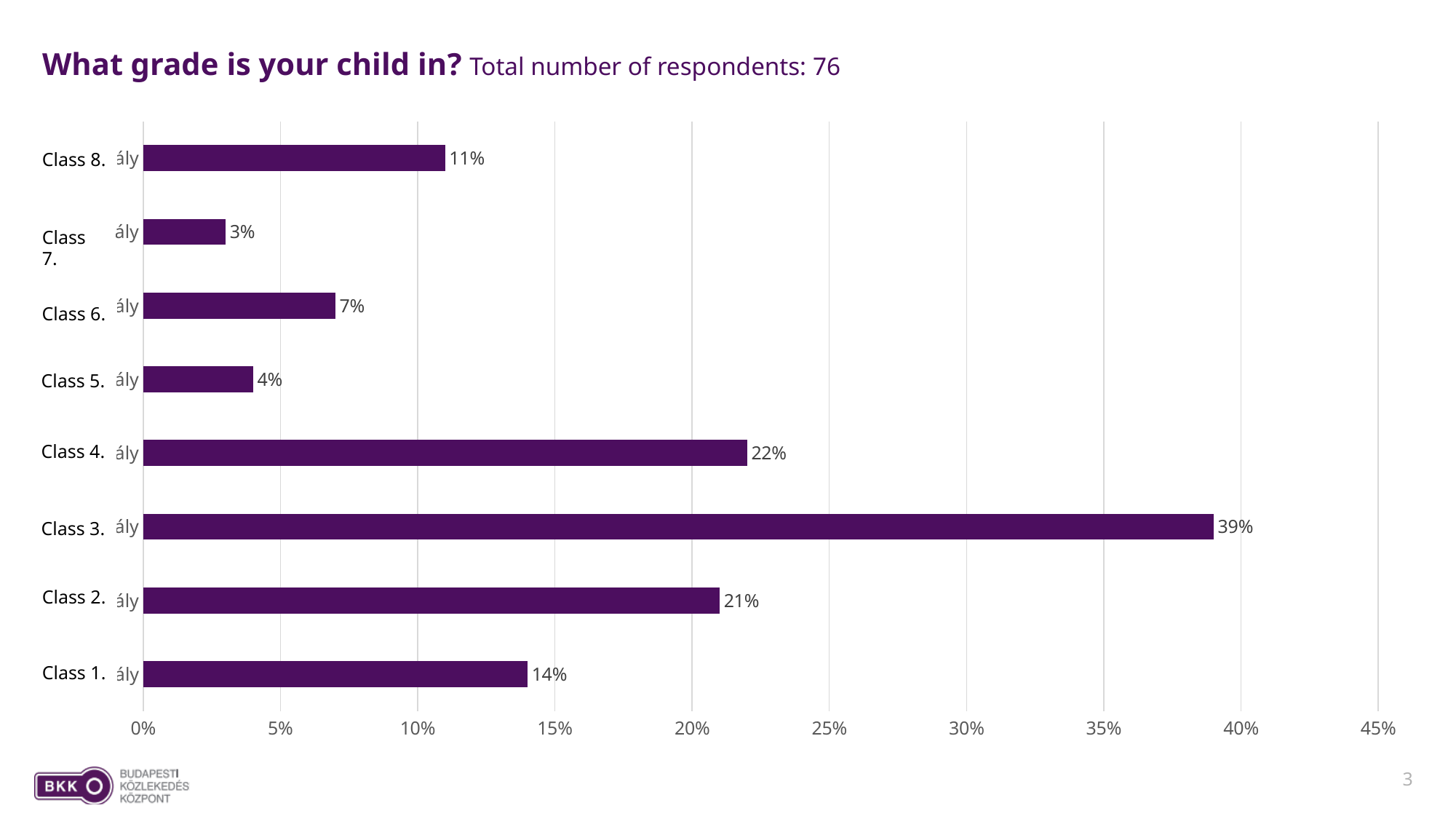
What is the value shown for Class 7? 3% What kind of chart is shown on the slide? bar chart Which class has the highest percentage of respondents? Class 3. Is the value for Class 2 greater or less than 20%? greater Which class has the lowest percentage of respondents? Class 7. What is the difference in percentage points between Class 3 and Class 4? 17 How many classes are shown in the chart? 8 What is the total number of respondents stated in the slide title? 76 What percentage is shown for Class 1? 14% What is the highest value shown on the x axis? 45% What percentage of respondents have a child in Class 3? 39% Which has a larger value, Class 8 or Class 6? Class 8.